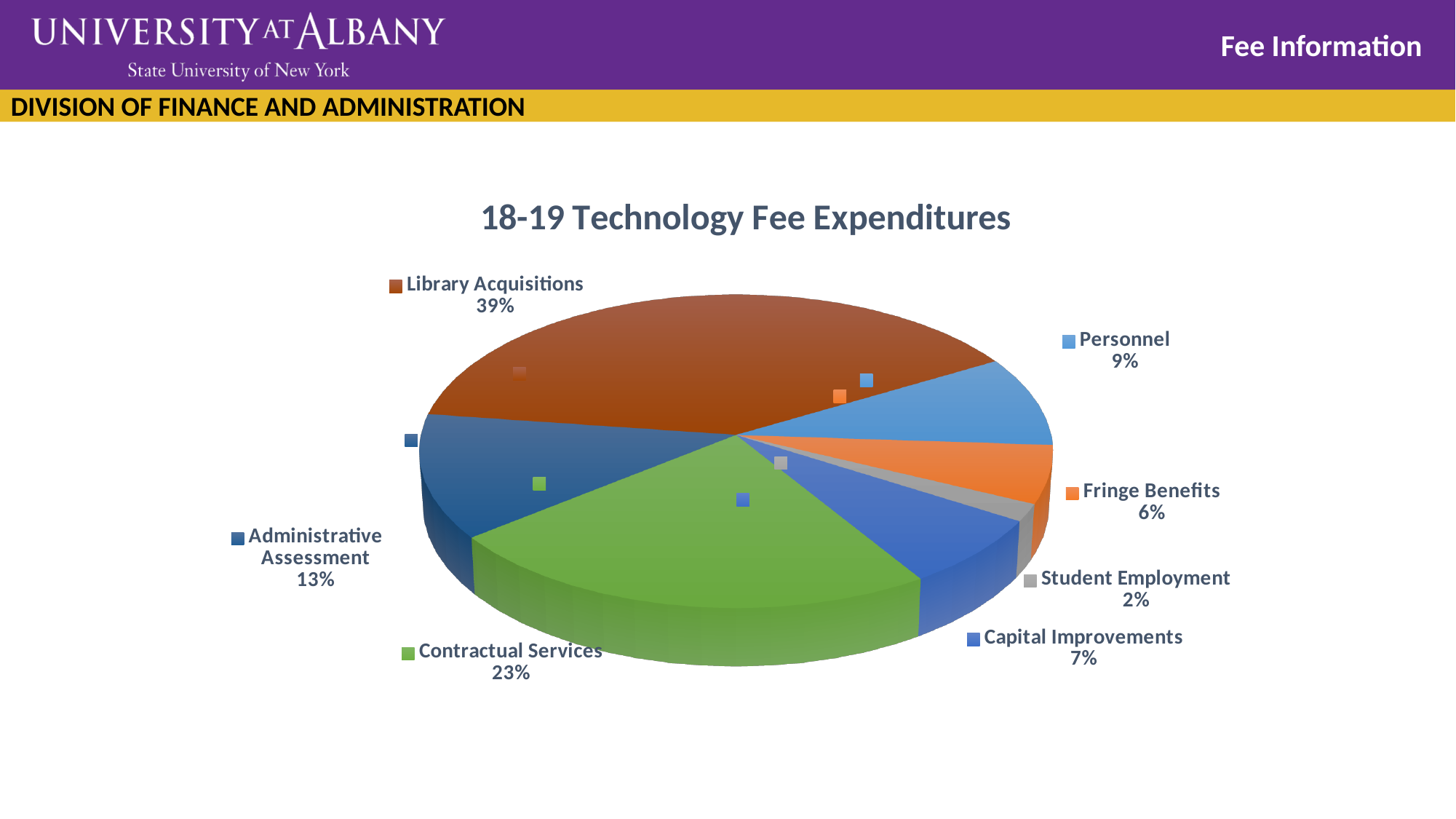
What is the title of the chart? 18-19 Technology Fee Expenditures What kind of chart is shown on the slide? Pie chart How many categories are shown in the pie chart? 7 What percentage is shown for Student Employment? 2% Which is larger, the share for Capital Improvements or the share for Fringe Benefits? Capital Improvements What percentage is shown for Administrative Assessment? 13% Which category has the smallest share of the expenditures? Student Employment What percentage of expenditures is shown for Contractual Services? 23% What percentage of expenditures went to Personnel? 9% What share of the 18-19 Technology Fee Expenditures went to Library Acquisitions? 39% How many percentage points larger is the Library Acquisitions share than the Contractual Services share? 16 Which category has the largest share of the 18-19 Technology Fee Expenditures? Library Acquisitions